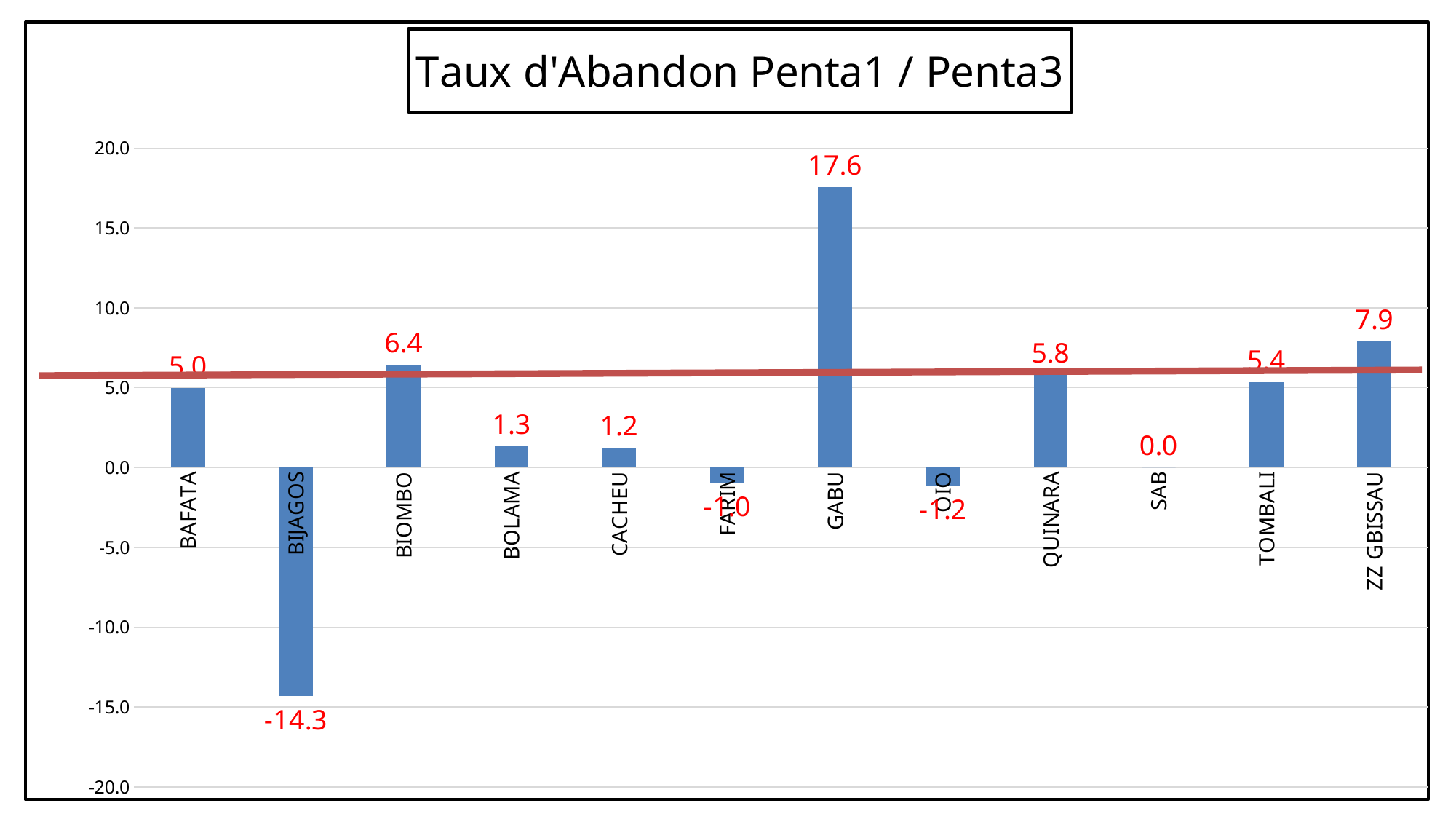
What is the value for SAB? 0.0 What is the title of the chart? Taux d'Abandon Penta1 / Penta3 Which category has the highest value? GABU What kind of chart is this? Bar chart Which category has the lowest value? BIJAGOS Which is larger, the value for BIOMBO or the value for QUINARA? BIOMBO What is the value for ZZ GBISSAU? 7.9 What is the difference between the values for GABU and ZZ GBISSAU? 9.7 How many categories are shown on the x axis? 12 What is the value for BIJAGOS? -14.3 What is the value for GABU? 17.6 What is the difference between the values for BOLAMA and CACHEU? 0.1